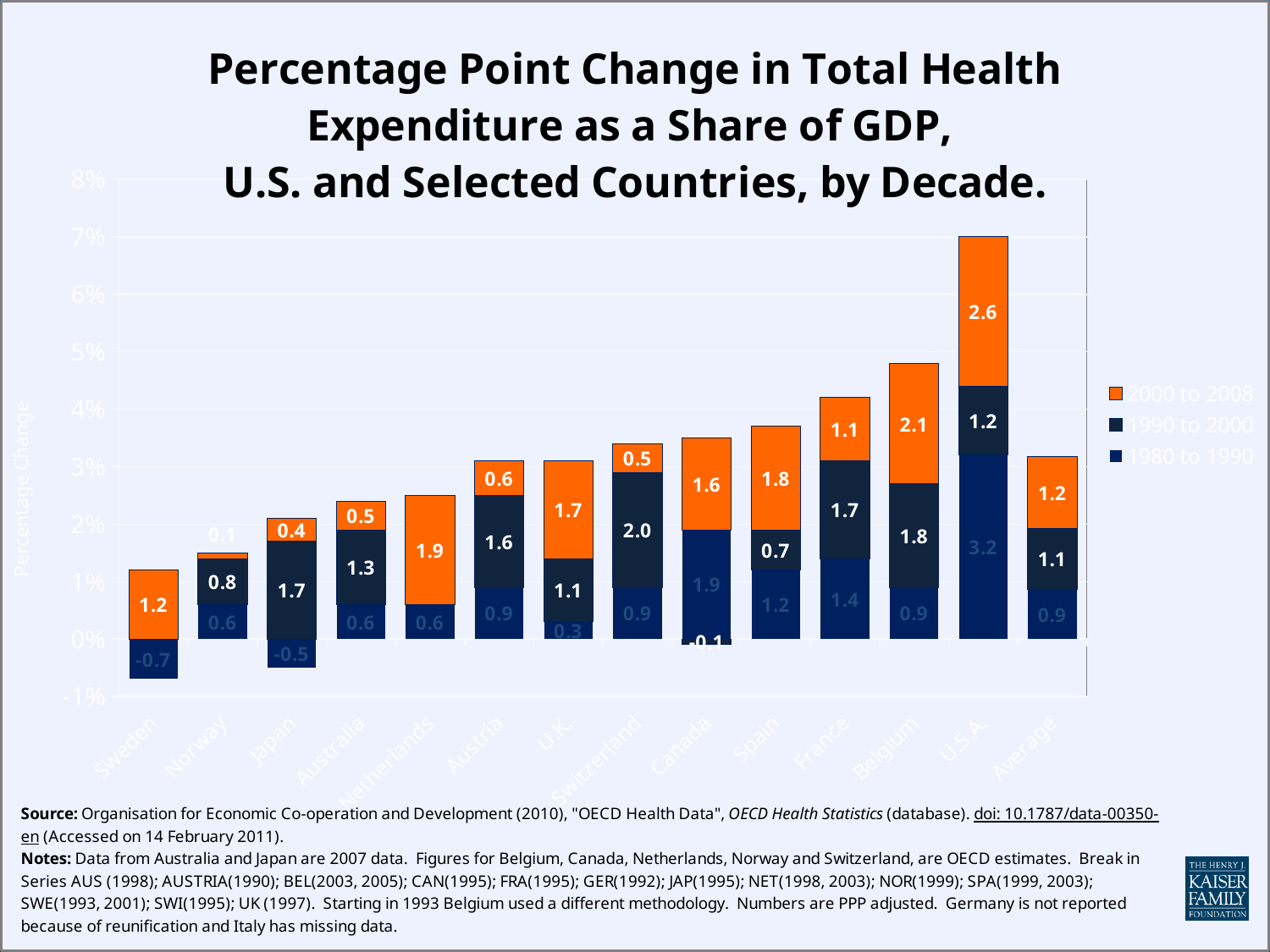
Which country has the lowest 1980 to 1990 value? Sweden What is the 2000 to 2008 value for the U.S.A.? 2.6 How many series does the legend list? 3 What colour represents the 2000 to 2008 series in the legend? Orange What is the total of the stacked bar for the U.S.A.? 7.0 What is the 1990 to 2000 value for Belgium? 1.8 What is the difference between the 2000 to 2008 values for Belgium and Average? 0.9 What kind of chart is shown on the slide? Stacked bar chart How many countries/categories are shown along the x axis? 14 Which country has the highest 2000 to 2008 value? U.S.A. What is the 1980 to 1990 value for Sweden? -0.7 Which has the larger 1990 to 2000 value, Switzerland or Austria? Switzerland